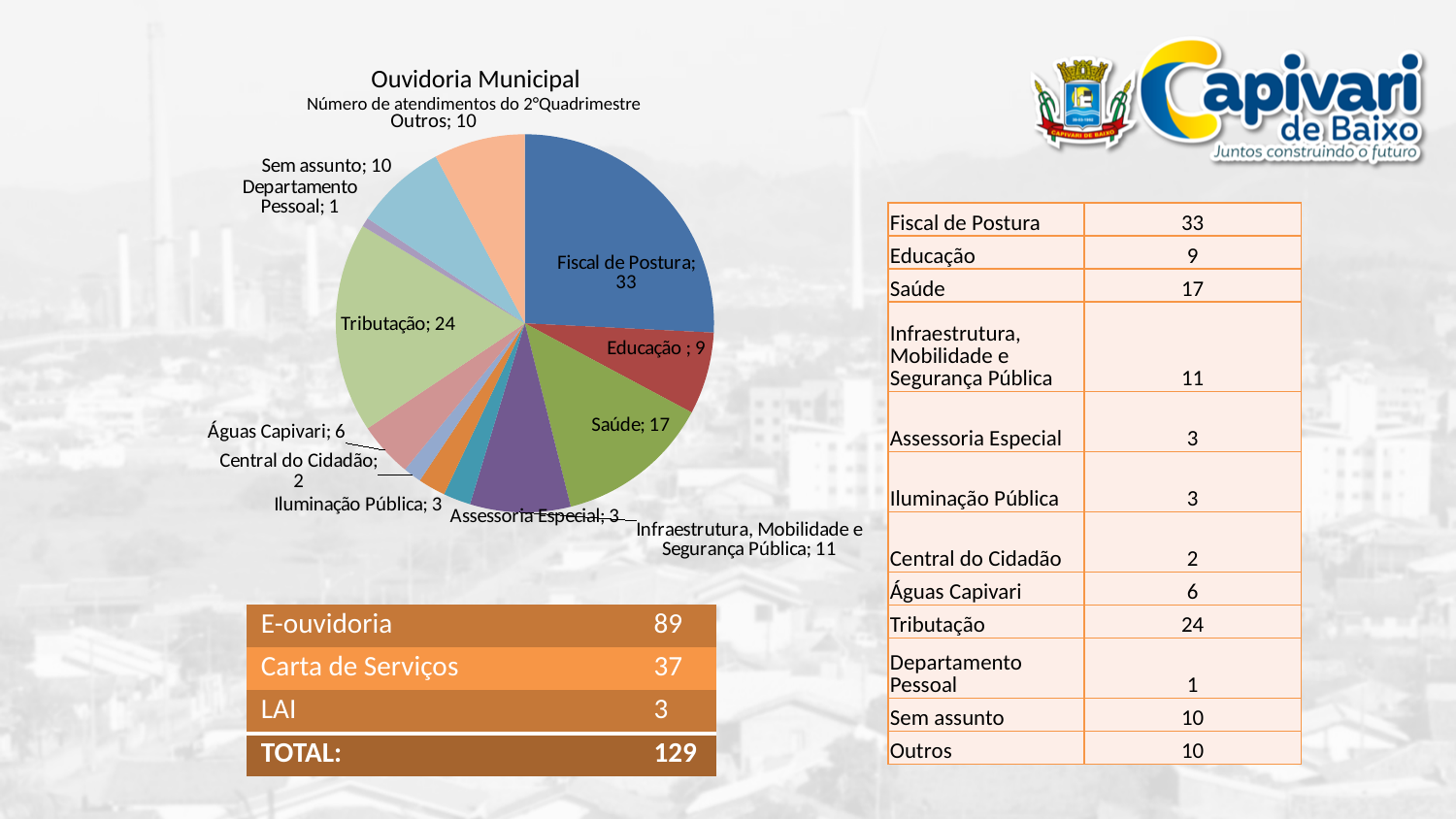
Which category has the smallest slice of the pie chart? Departamento Pessoal What is the title of the chart? Ouvidoria Municipal How many atendimentos does the chart show for Fiscal de Postura? 33 Which is larger in the pie chart, Saúde or Educação? Saúde What is the difference between the values for Fiscal de Postura and Tributação? 9 What is the value for Central do Cidadão in the pie chart? 2 What is the value for Tributação in the pie chart? 24 What is the value for Infraestrutura, Mobilidade e Segurança Pública in the pie chart? 11 What is the total of all the values in the pie chart? 129 How many categories (slices) does the pie chart have? 12 What kind of chart is shown on the slide? Pie chart Which category has the largest slice of the pie chart? Fiscal de Postura